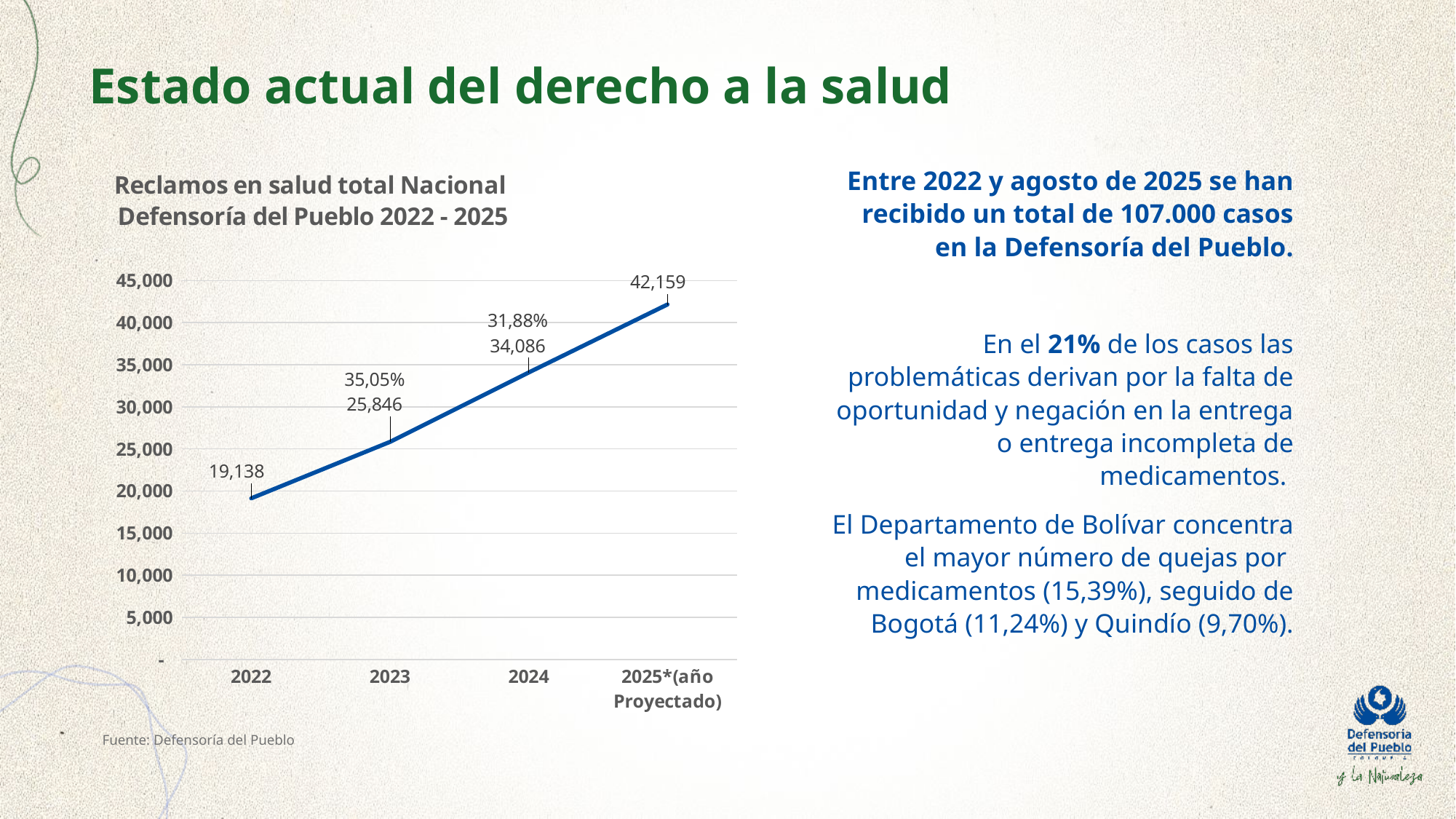
What is the value for 2024 in the chart? 34,086 Do the values rise or fall from 2022 to 2025 in the chart? Rise What is the difference between the values for 2024 and 2023? 8,240 What is the value for 2023 in the chart? 25,846 Which is larger, the value for 2024 or the value for 2023? 2024 Which year has the lowest value in the chart? 2022 What is the projected value for 2025 in the chart? 42,159 What is the value for 2022 in the chart? 19,138 What is the difference between the values for 2023 and 2022? 6,708 Which year has the highest value in the chart? 2025*(año Proyectado) How many years are plotted on the x axis of the chart? 4 What kind of chart is shown on the slide? Line chart